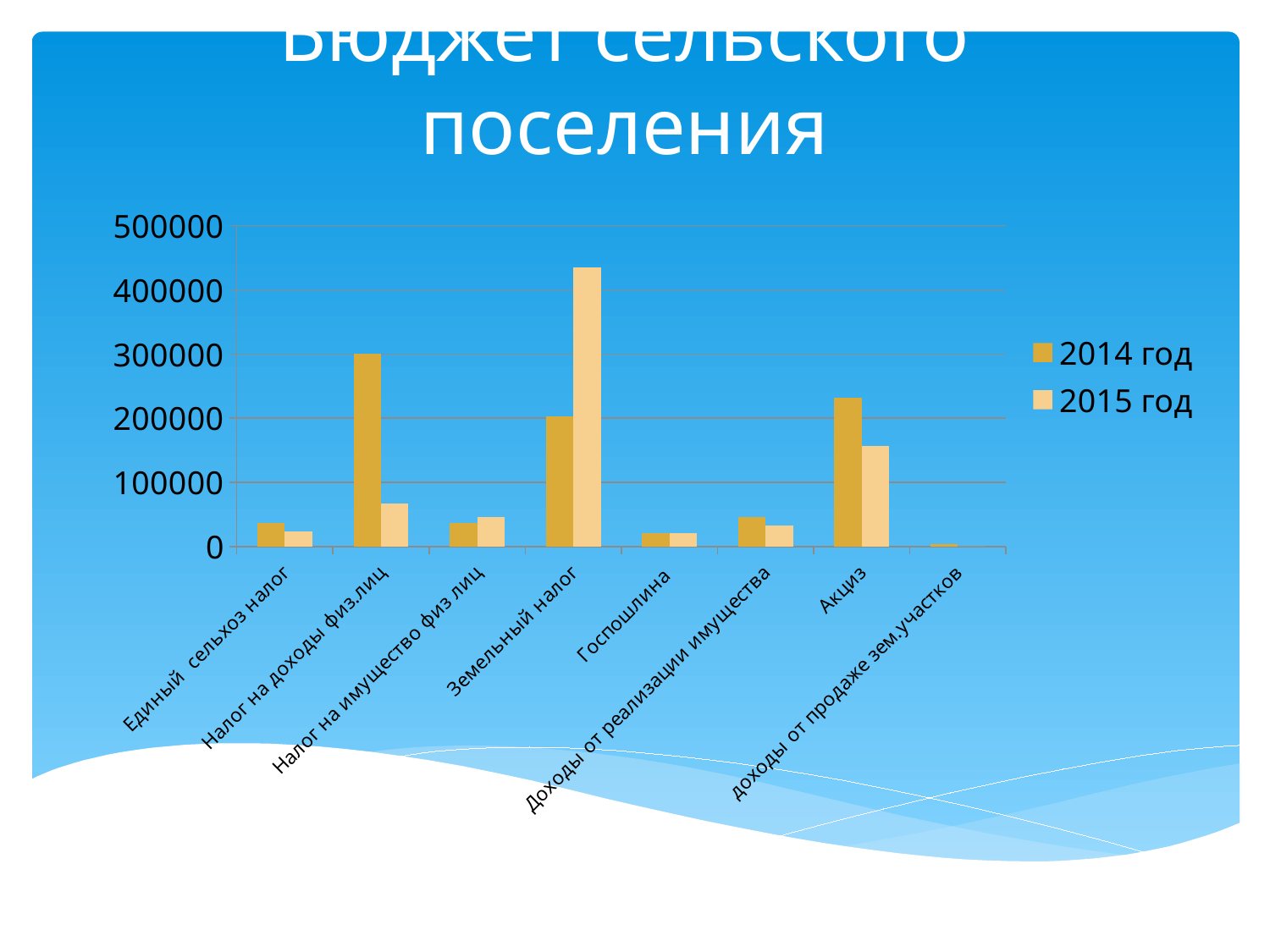
Is the value for Земельный налог in 2015 год greater or less than 400000? greater What are the two entries in the legend? 2014 год and 2015 год How many categories are shown on the x axis? 8 Which is larger for Акциз: the 2014 год value or the 2015 год value? 2014 год Which category has the highest value for 2014 год? Налог на доходы физ.лиц How many series does the legend list? 2 What kind of chart is shown on the slide? bar chart Is the value for Акциз in 2014 год greater or less than 200000? greater Is the value for Налог на доходы физ.лиц in 2015 год greater or less than 100000? less Which is larger for Земельный налог: the 2014 год value or the 2015 год value? 2015 год What is the title of the chart? Бюджет сельского поселения Which category has the highest value for 2015 год? Земельный налог